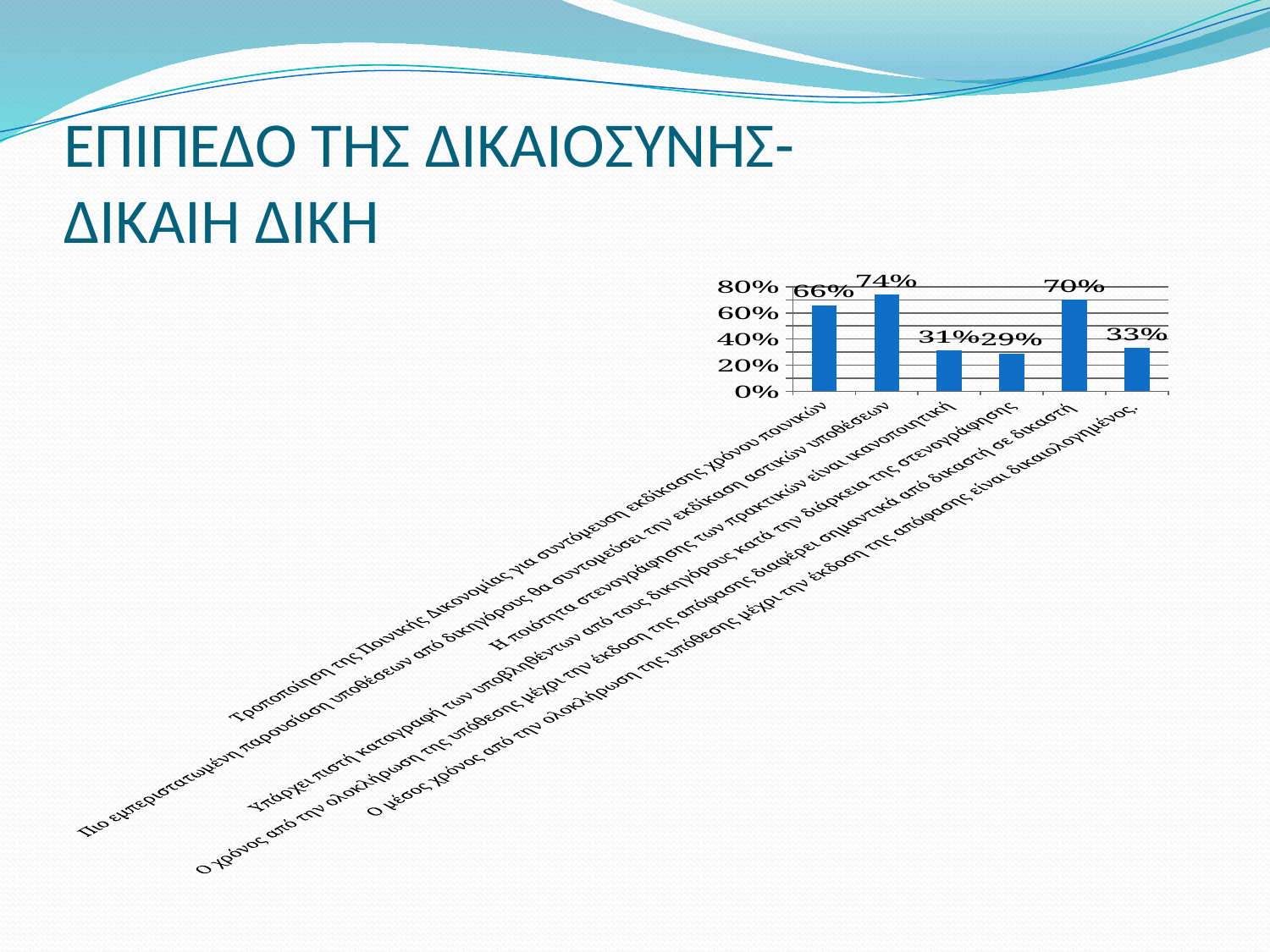
What is the difference between the values of the first bar (66%) and the second bar (74%)? 8% What is the value for "Η ποιότητα στενογράφησης των πρακτικών είναι ικανοποιητική"? 31% How many categories (bars) does the chart show? 6 What is the value for "Ο μέσος χρόνος από την ολοκλήρωση της υπόθεσης μέχρι την έκδοση της απόφασης είναι δικαιολογημένος"? 33% What is the difference between the highest value (74%) and the lowest value (29%)? 45% Is the value for "Η ποιότητα στενογράφησης των πρακτικών είναι ικανοποιητική" greater or less than 40%? less What type of chart is shown on the slide? bar chart What is the value for "Τροποποίηση της Ποινικής Δικονομίας για συντόμευση εκδίκασης χρόνου ποινικών"? 66% What is the highest tick value shown on the vertical axis? 80% Which category has the lowest value? Υπάρχει πιστή καταγραφή των υποβληθέντων από τους δικηγόρους κατά την διάρκεια της στενογράφησης Which category has the highest value? Πιο εμπεριστατωμένη παρουσίαση υποθέσεων από δικηγόρους θα συντομεύσει την εκδίκαση αστικών υποθέσεων Which is larger: the value for "Τροποποίηση της Ποινικής Δικονομίας..." (first bar) or the value for "Ο χρόνος από την ολοκλήρωση της υπόθεσης... διαφέρει σημαντικά από δικαστή σε δικαστή" (fifth bar)? Ο χρόνος από την ολοκλήρωση της υπόθεσης... διαφέρει σημαντικά από δικαστή σε δικαστή (70%)